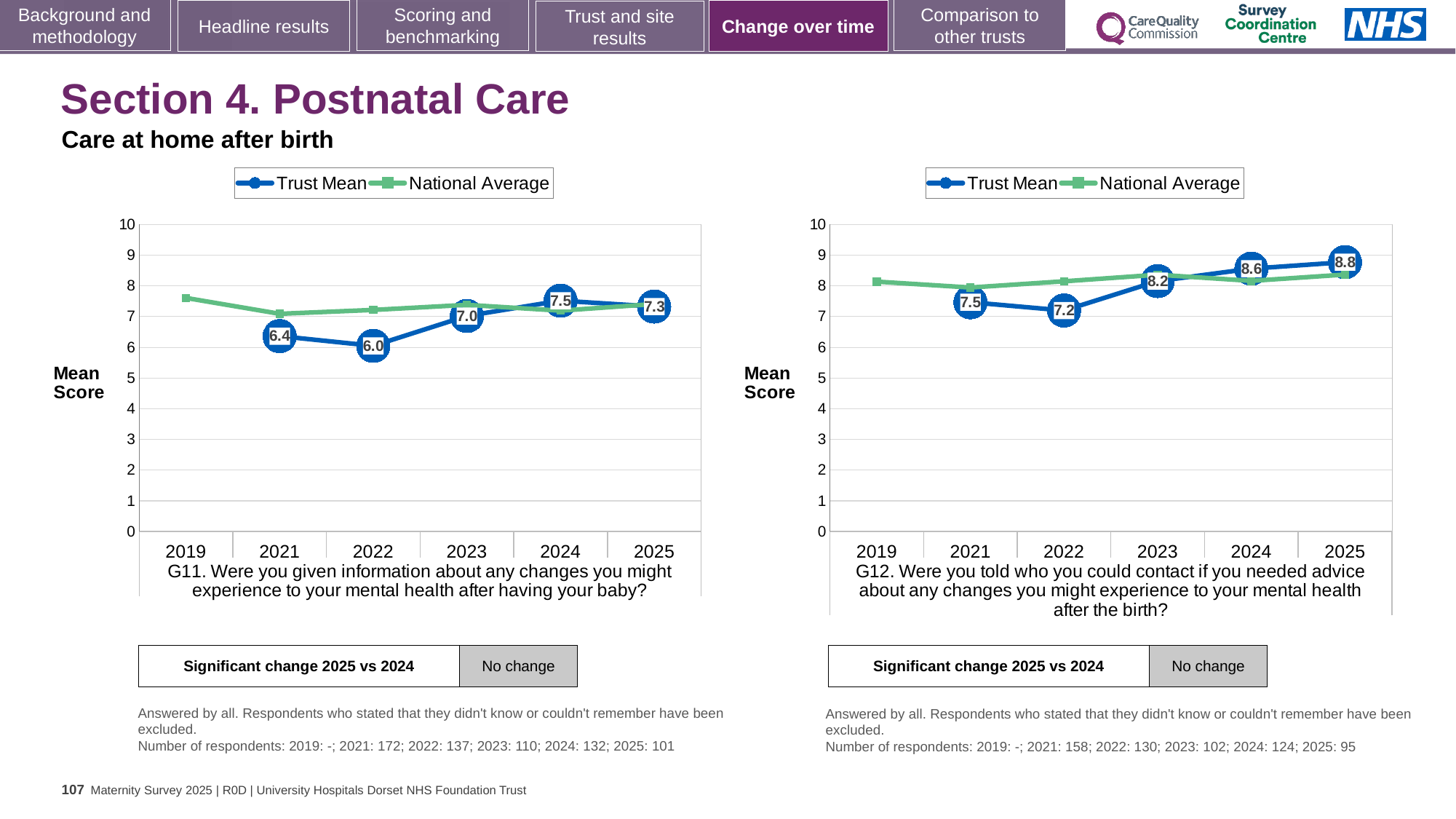
In the G11 chart on the left, is the National Average for 2019 greater or less than 7? greater In the G11 chart on the left, what is the Trust Mean for 2022? 6.0 How many series does the legend of the G12 chart on the right list? 2 What kind of chart is the G11 chart on the left? Line chart In the G12 chart on the right, is the National Average for 2025 greater or less than 9? less In the G12 chart on the right, which year has the lowest Trust Mean? 2022 How many years are shown on the x axis of the G11 chart on the left? 6 In the G12 chart on the right, which is larger, the Trust Mean for 2021 or for 2023? 2023 In the G11 chart on the left, what is the difference between the Trust Mean for 2024 and 2022? 1.5 In the G11 chart on the left, which year has the highest Trust Mean? 2024 In the G12 chart on the right, what is the Trust Mean for 2025? 8.8 In the G12 chart on the right, does the Trust Mean rise or fall from 2022 to 2025? Rise